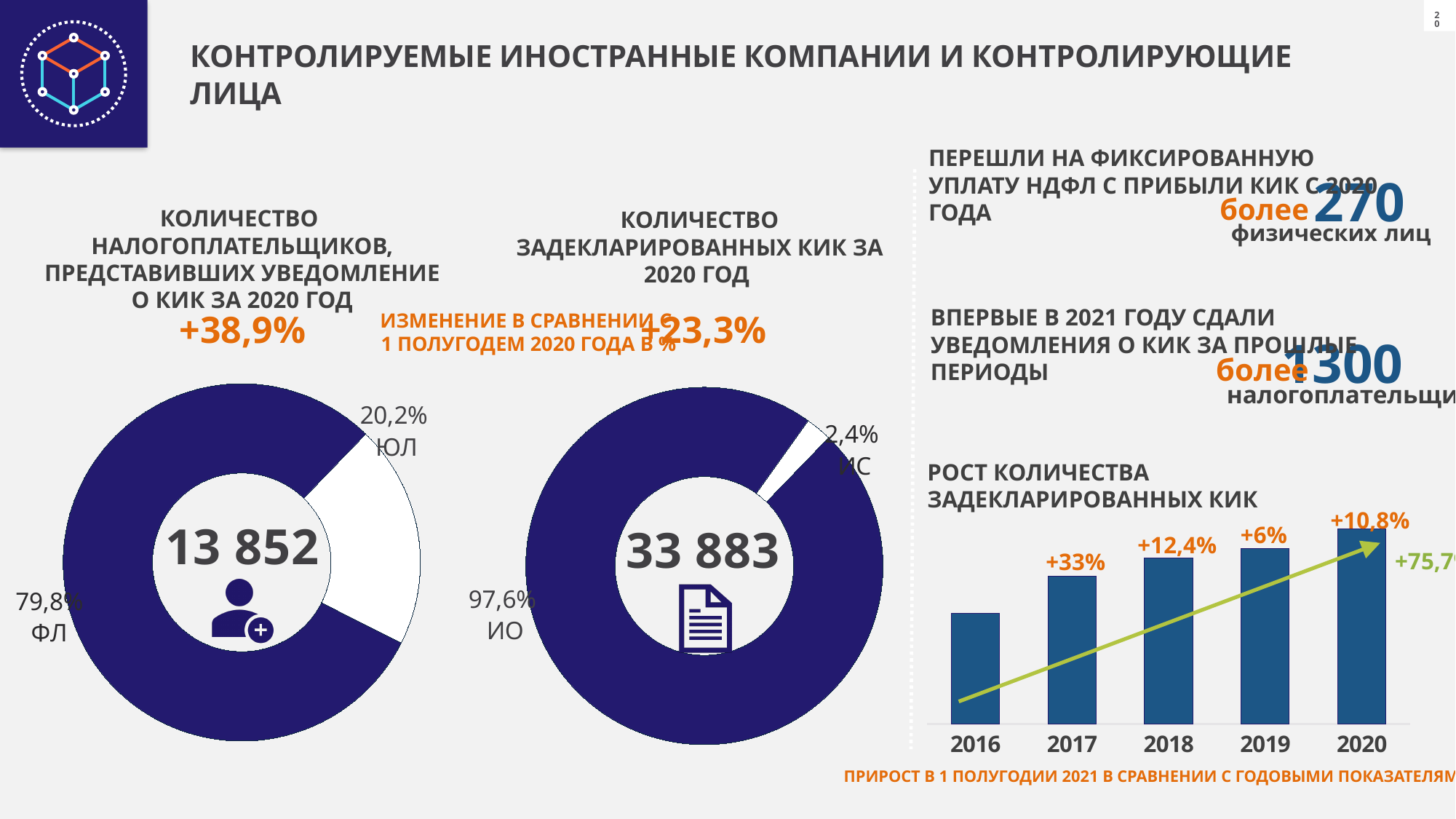
What kind of chart is the one titled РОСТ КОЛИЧЕСТВА ЗАДЕКЛАРИРОВАННЫХ КИК? bar chart What total number is shown in the centre of the middle donut chart? 33 883 In the bar chart РОСТ КОЛИЧЕСТВА ЗАДЕКЛАРИРОВАННЫХ КИК, which year has the shortest bar? 2016 In the bar chart РОСТ КОЛИЧЕСТВА ЗАДЕКЛАРИРОВАННЫХ КИК, what growth percentage is labelled above the 2017 bar? +33% In the left donut chart (КОЛИЧЕСТВО НАЛОГОПЛАТЕЛЬЩИКОВ, ПРЕДСТАВИВШИХ УВЕДОМЛЕНИЕ О КИК ЗА 2020 ГОД), what share is labelled ФЛ? 79,8% In the middle donut chart, what share is labelled ИС? 2,4% In the left donut chart, what share is labelled ЮЛ? 20,2% In the middle donut chart, which segment is larger, ИО or ИС? ИО What total number is shown in the centre of the left donut chart? 13 852 In the bar chart РОСТ КОЛИЧЕСТВА ЗАДЕКЛАРИРОВАННЫХ КИК, which year has the tallest bar? 2020 How many years are shown on the x axis of the bar chart РОСТ КОЛИЧЕСТВА ЗАДЕКЛАРИРОВАННЫХ КИК? 5